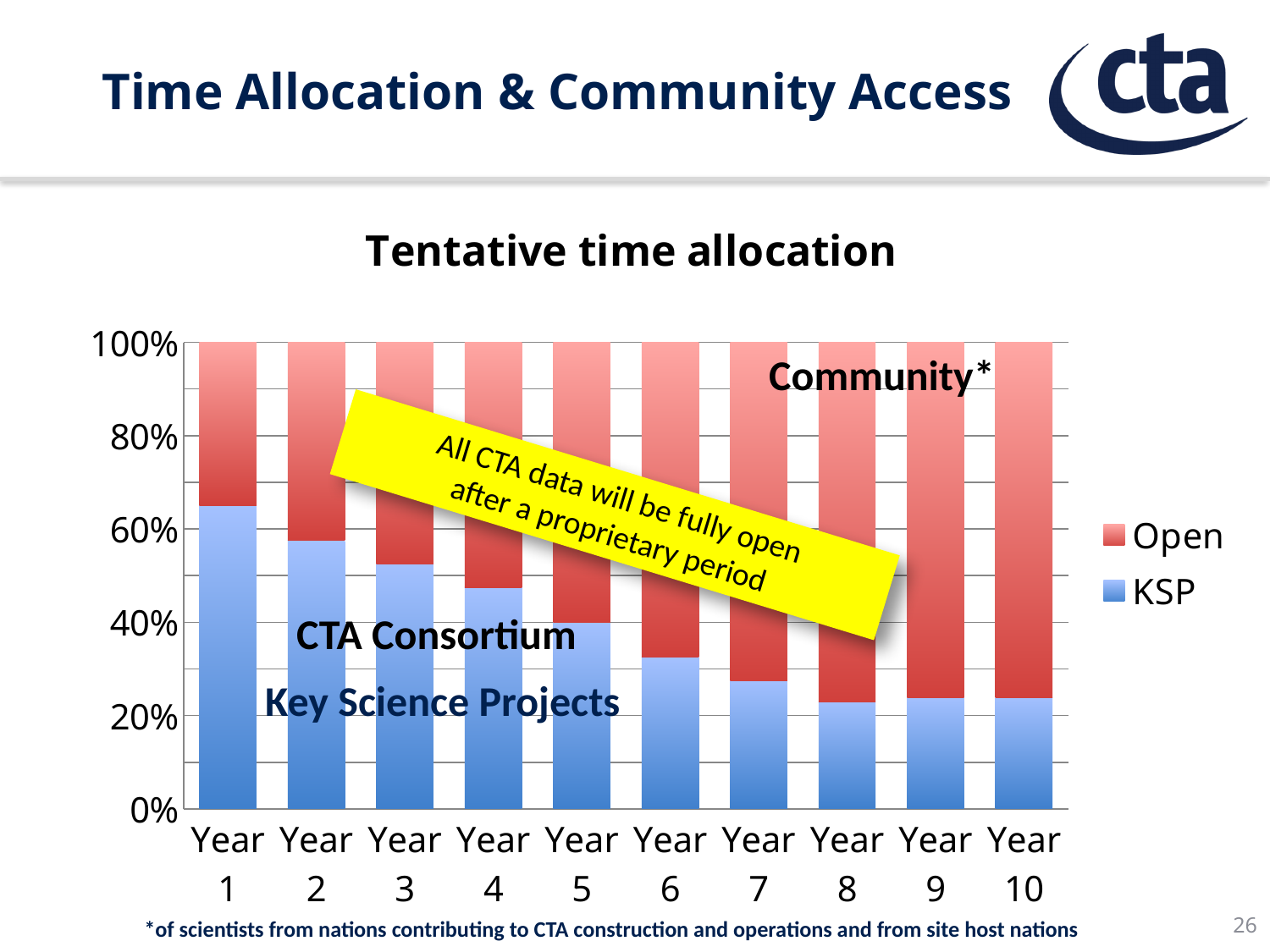
What is the total of the stacked bar for Year 1? 100% Does the Open share rise or fall from Year 1 to Year 10? Rise What kind of chart is shown on the slide? Stacked bar chart How many series does the legend list? 2 Is the KSP value for Year 10 greater or less than 40%? less Which year has the highest KSP share? Year 1 Is the KSP value for Year 1 greater or less than 60%? greater What is the title of the chart? Tentative time allocation Which year has the larger KSP share, Year 2 or Year 6? Year 2 Is the KSP value for Year 3 greater or less than 40%? greater Does the KSP share rise or fall from Year 1 to Year 10? Fall How many years (categories) are shown on the x axis? 10